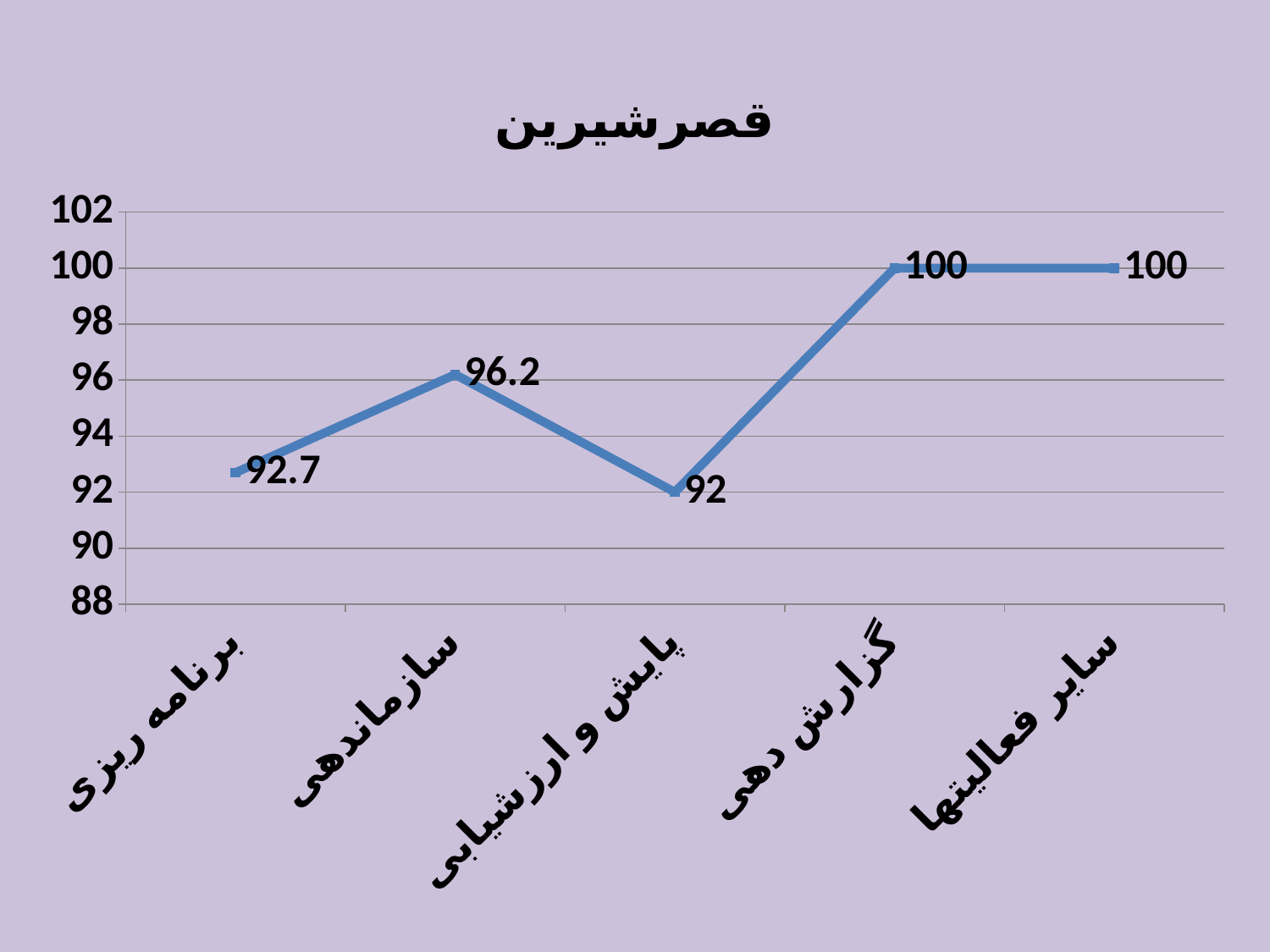
What is the difference between the values for گزارش دهی and برنامه ریزی? 7.3 How many categories are shown on the x axis? 5 What is the value for سازماندهی? 96.2 Which is larger, the value for سازماندهی or the value for برنامه ریزی? سازماندهی What is the title of the chart? قصرشیرین What is the value for گزارش دهی? 100 What kind of chart is shown on the slide? line chart Is the value for سازماندهی greater or less than 94? greater What is the value for برنامه ریزی? 92.7 What is the difference between the values for سازماندهی and پایش و ارزشیابی? 4.2 Which category has the lowest value? پایش و ارزشیابی What is the value for پایش و ارزشیابی? 92